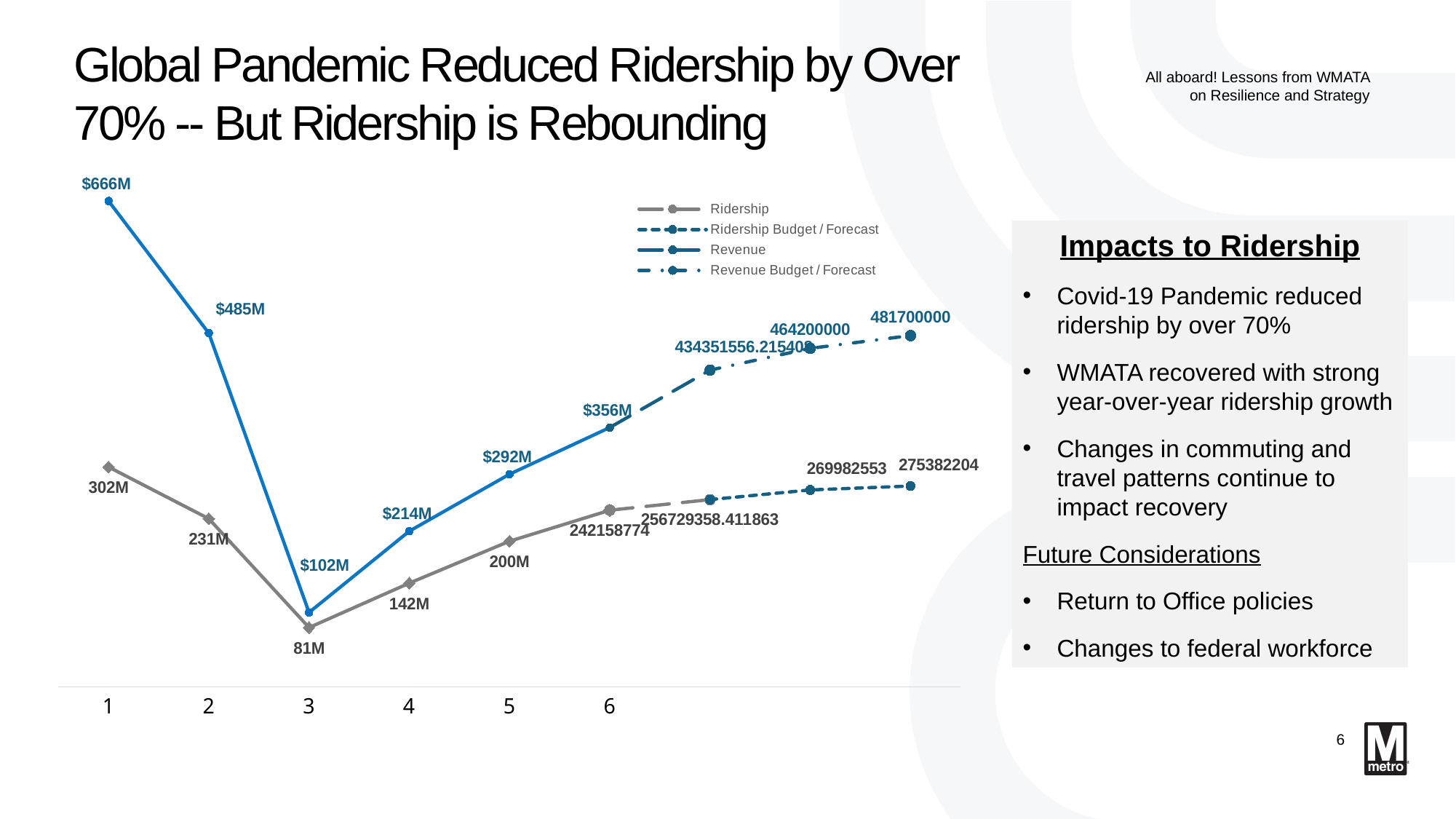
Which is larger, the Ridership value at category 2 or at category 4? category 2 (231M) How many series does the chart legend list? 4 What is the Ridership value at x-axis category 3? 81M What is the difference between the Revenue values at categories 1 and 2? $181M What is the last labeled value on the Revenue Budget / Forecast line? 481700000 What is the Ridership value at x-axis category 5? 200M At which x-axis category is Ridership highest? 1 What is the Revenue value at x-axis category 6? $356M Does Revenue rise or fall from x-axis category 3 to category 6? rise At which x-axis category is Revenue lowest? 3 What is the Revenue value at x-axis category 1? $666M What type of chart is shown on the slide? line chart